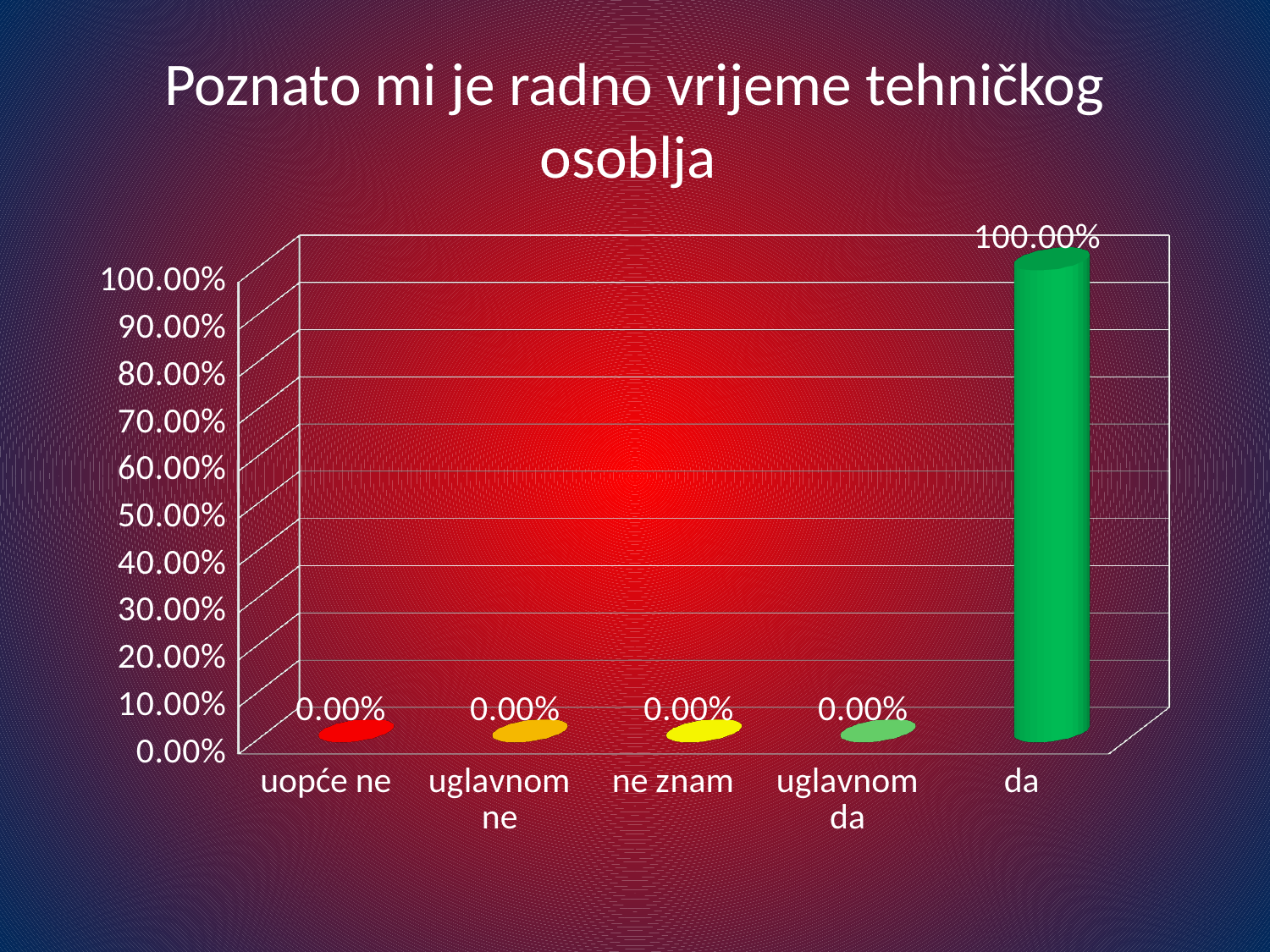
How many categories are shown on the x axis? 5 Which is larger, the value for "da" or the value for "uglavnom ne"? da What is the value for "ne znam"? 0.00% Which category has the highest value? da What is the difference between the values for "da" and "uglavnom da"? 100.00% What colour is the bar for "da"? green What is the title of the chart? Poznato mi je radno vrijeme tehničkog osoblja What kind of chart is shown on the slide? bar chart What is the value for "uopće ne"? 0.00% Is the value for "da" greater or less than 50.00%? greater What is the value for "da"? 100.00% What is the value for "uglavnom da"? 0.00%